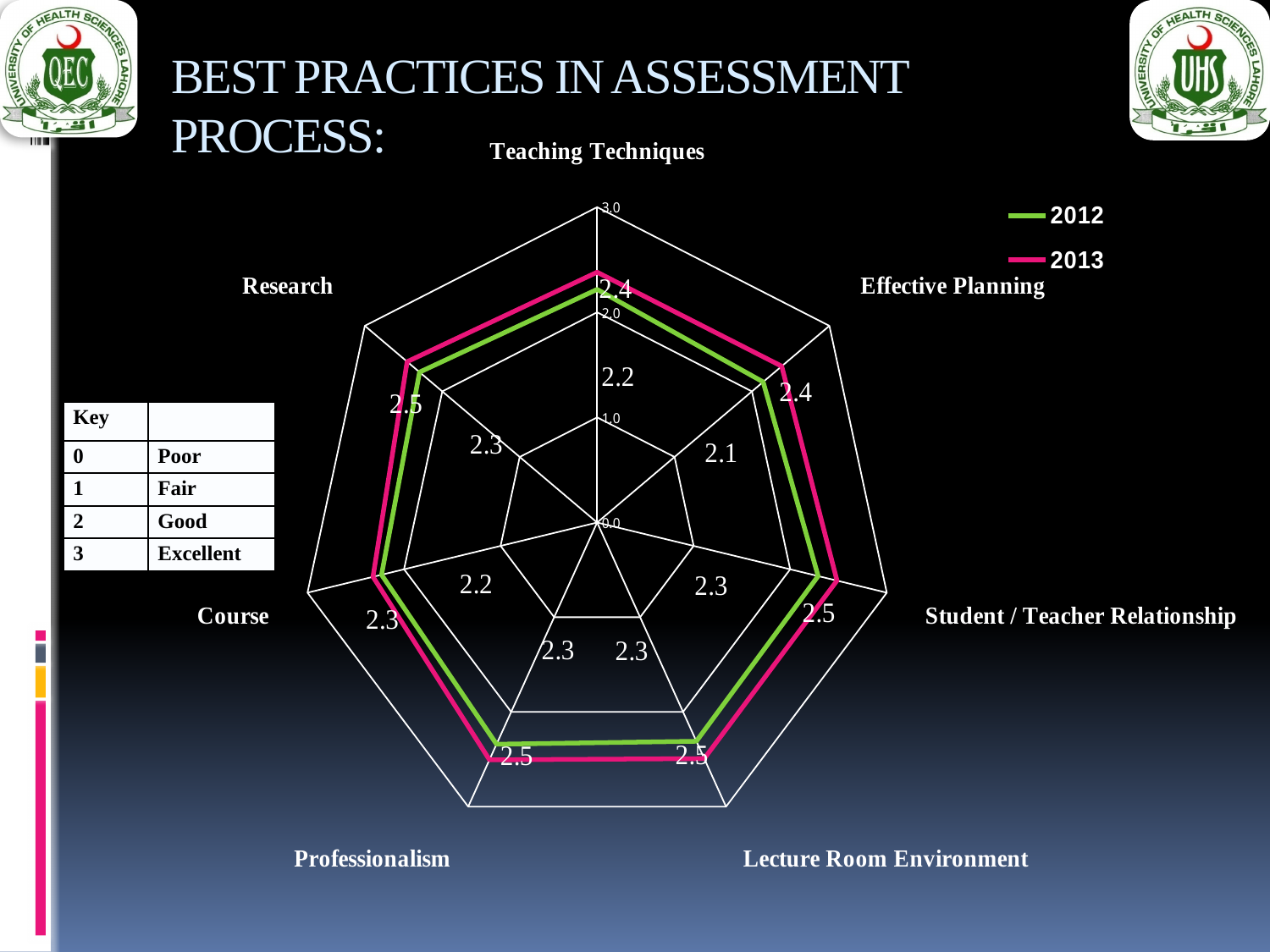
How many series does the legend list? 2 How many categories (axes) does the radar chart have? 7 What is the 2013 value for Student / Teacher Relationship? 2.5 What kind of chart is shown on the slide? Radar chart Which is larger for Research: the 2012 value or the 2013 value? 2013 What is the 2012 value for Effective Planning? 2.1 What is the difference between the 2013 and 2012 values for Effective Planning? 0.3 Which category has the lowest 2013 value? Course Which category has the lowest 2012 value? Effective Planning Which colour represents the 2013 series in the legend? Pink What is the 2013 value for Teaching Techniques? 2.4 What is the 2012 value for Course? 2.2